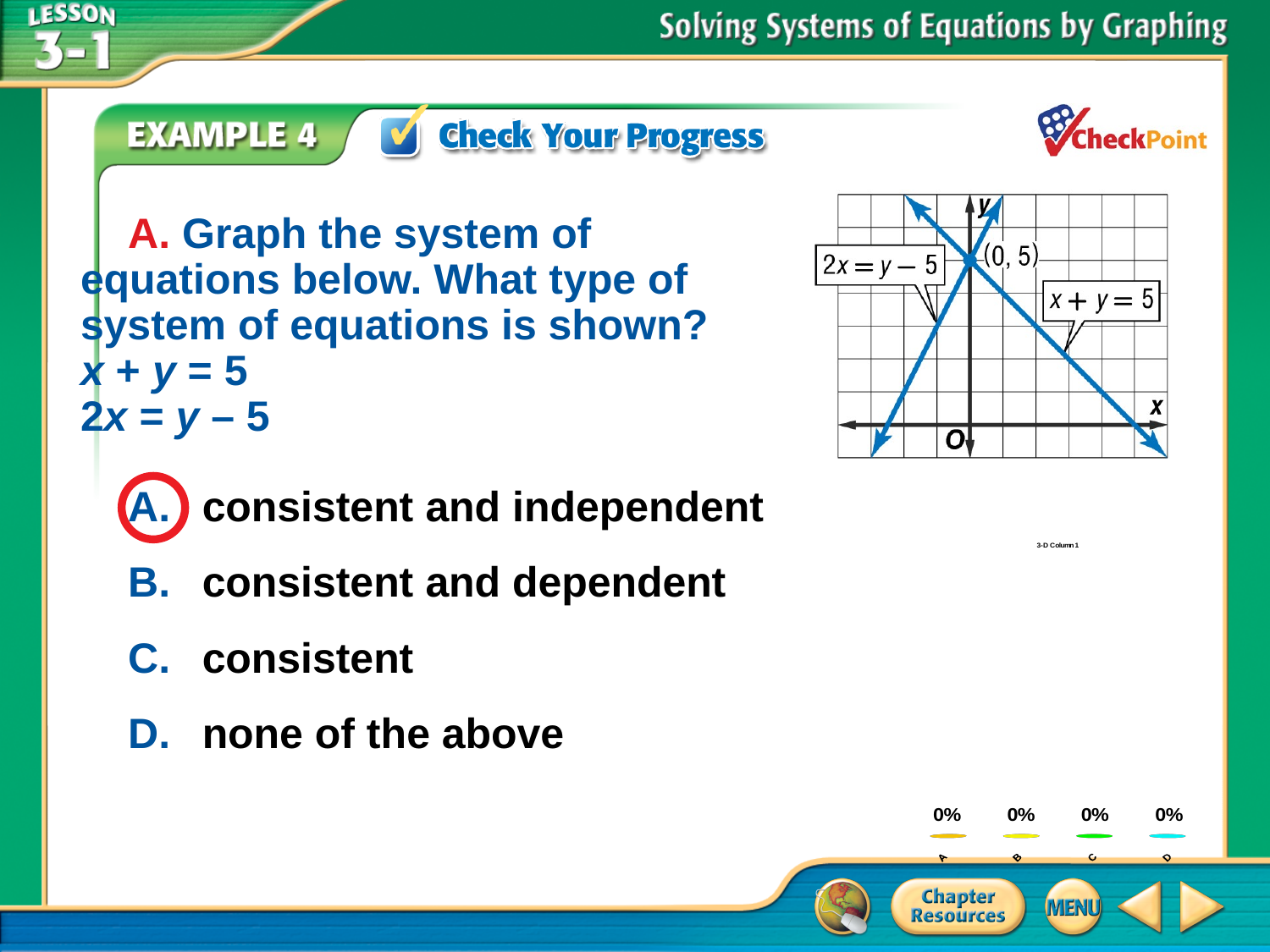
On the coordinate graph at the top right of the slide, at what point do the two lines intersect? (0, 5) On the bar chart at the bottom right of the slide, what is the difference between the values for A and C? 0% How many lines are plotted on the coordinate graph at the top right of the slide? 2 On the bar chart at the bottom right of the slide, what value is shown for category D? 0% What kind of chart is the small chart at the bottom right of the slide? bar chart On the bar chart at the bottom right of the slide, what value is shown for category B? 0% On the bar chart at the bottom right of the slide, what are the category labels along the x axis? A, B, C, D How many categories does the bar chart at the bottom right of the slide show? 4 What is the title printed above the bar chart at the bottom right of the slide? 3-D Column 1 On the bar chart at the bottom right of the slide, what value is shown for category A? 0%